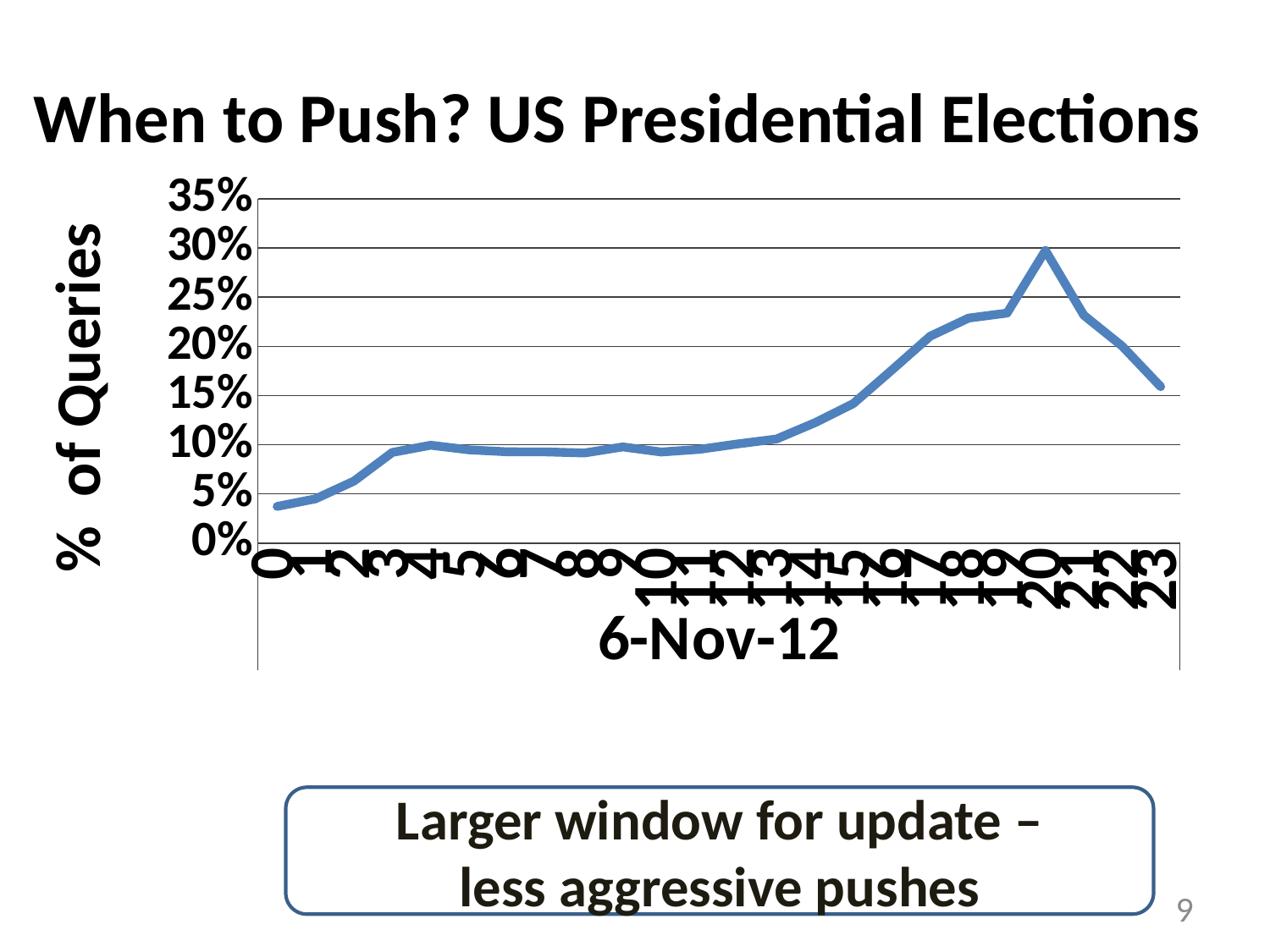
What date label is shown beneath the horizontal axis of the chart? 6-Nov-12 Is the value at the rightmost point of the line greater or less than 20%? less Is the value at the rightmost point of the line greater or less than 10%? greater Does the line rise or fall from its peak to the right end of the chart? fall Is the highest value reached by the line greater or less than 25%? greater Overall, does the line rise or fall from the leftmost point up to its peak? rise What is the title of the vertical axis of the chart? % of Queries What type of chart is shown on the slide? line chart